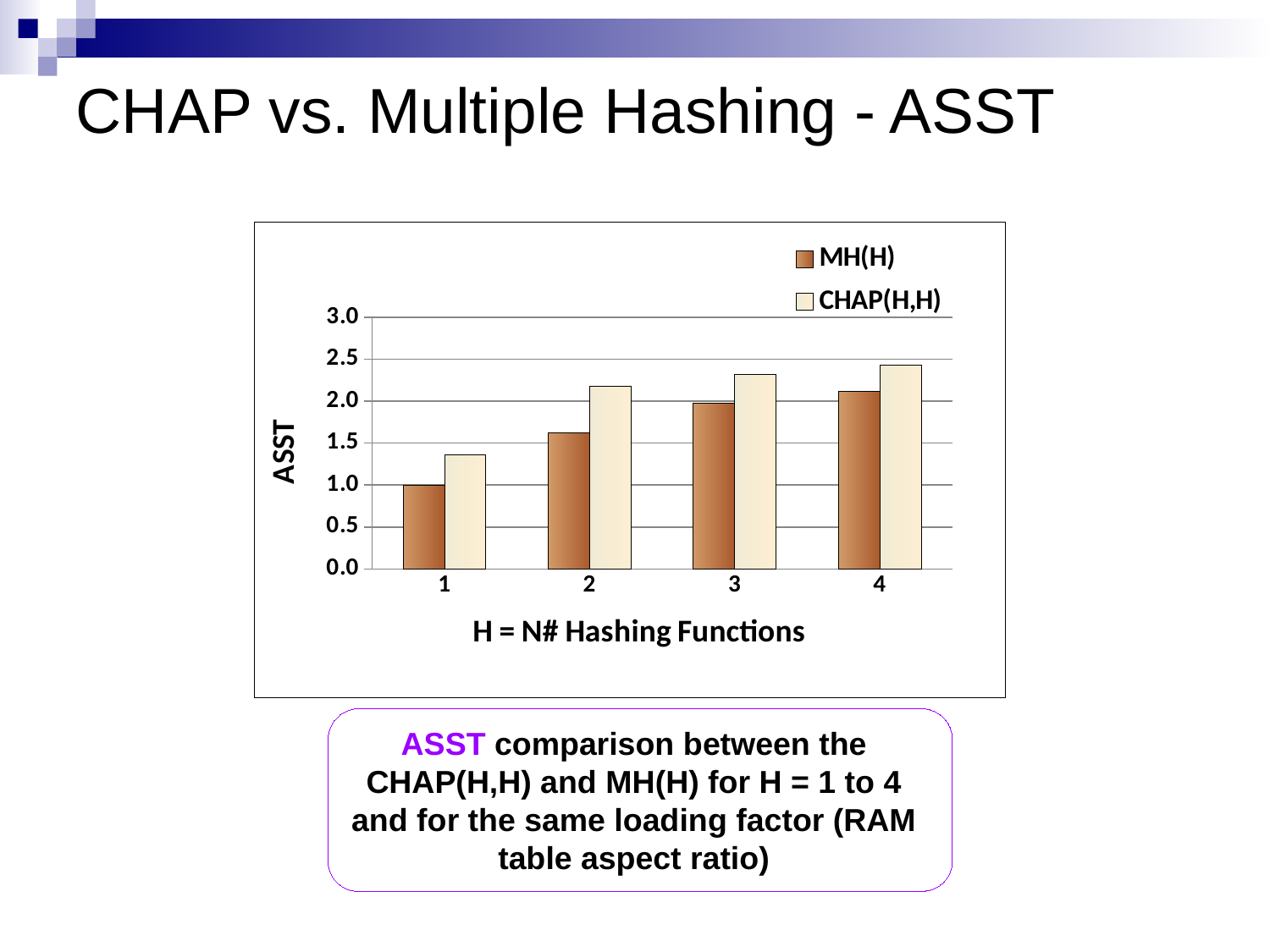
At H = 1, which series has the larger ASST value, MH(H) or CHAP(H,H)? CHAP(H,H) For which value of H is the MH(H) bar the lowest? 1 How many categories (values of H) are shown on the x axis? 4 Is the CHAP(H,H) value at H = 4 greater or less than 2.0? greater Is the CHAP(H,H) value at H = 1 greater or less than 1.5? less How many series does the legend list? 2 What is the ASST value for MH(H) at H = 1? 1.0 Is the MH(H) value at H = 2 greater or less than 1.5? greater Do the MH(H) values rise or fall as H increases from 1 to 4? rise What kind of chart is shown on the slide? bar chart What is the title of the x axis? H = N# Hashing Functions For which value of H is the CHAP(H,H) bar the highest? 4